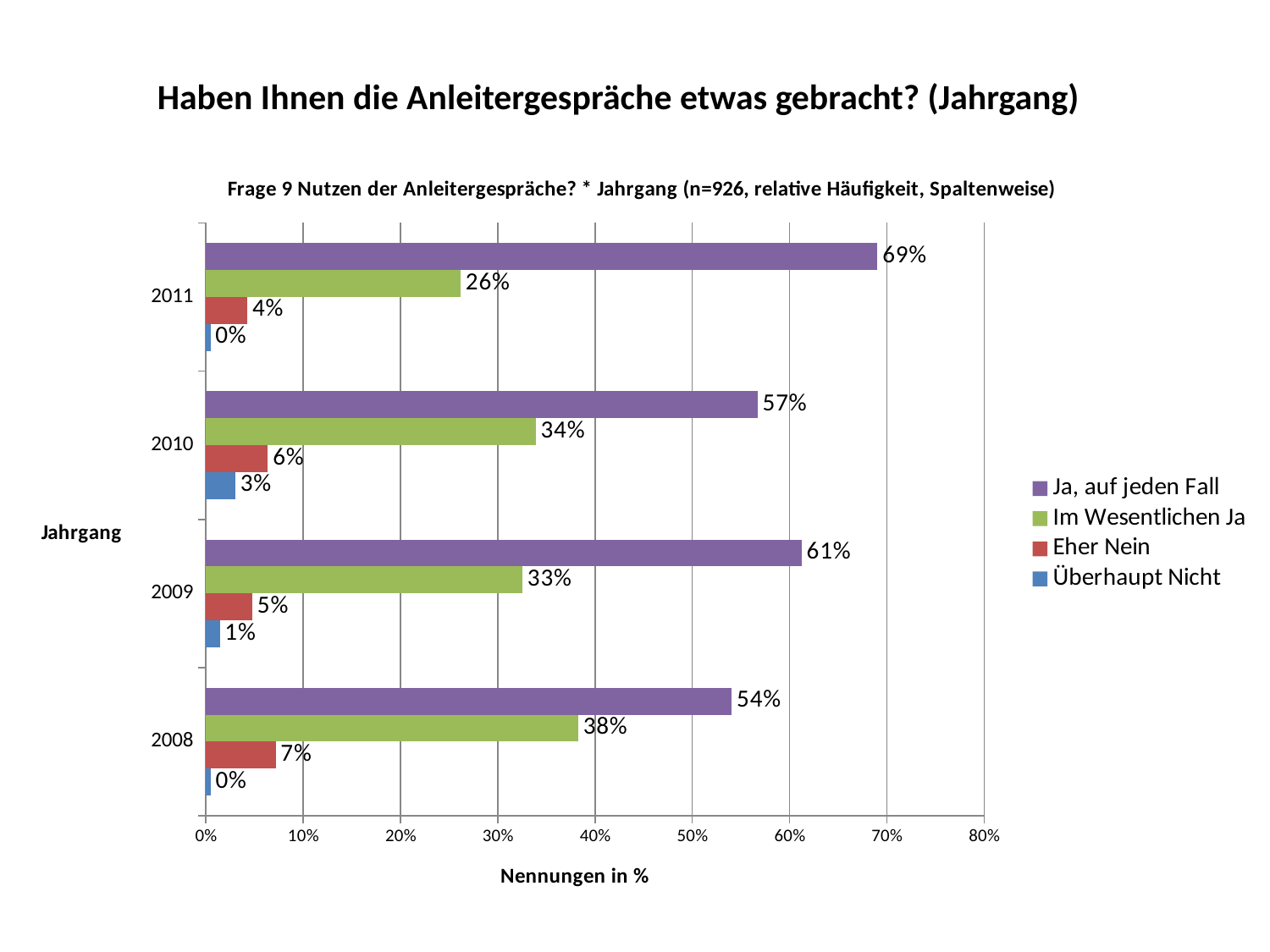
What is the value for "Überhaupt Nicht" in 2009? 1% How many series does the legend list? 4 What is the difference between the "Ja, auf jeden Fall" values for 2011 and 2008? 15% How many years (Jahrgang) are shown on the chart? 4 What is the value for "Eher Nein" in 2010? 6% What is the value for "Im Wesentlichen Ja" in 2008? 38% Which year has the lowest value for "Im Wesentlichen Ja"? 2011 Which is larger: "Im Wesentlichen Ja" in 2010 or in 2009? 2010 Which year has the highest value for "Ja, auf jeden Fall"? 2011 What is the value for "Ja, auf jeden Fall" in 2011? 69% Is the value for "Ja, auf jeden Fall" in 2009 greater or less than 50%? greater What kind of chart is shown on the slide? bar chart